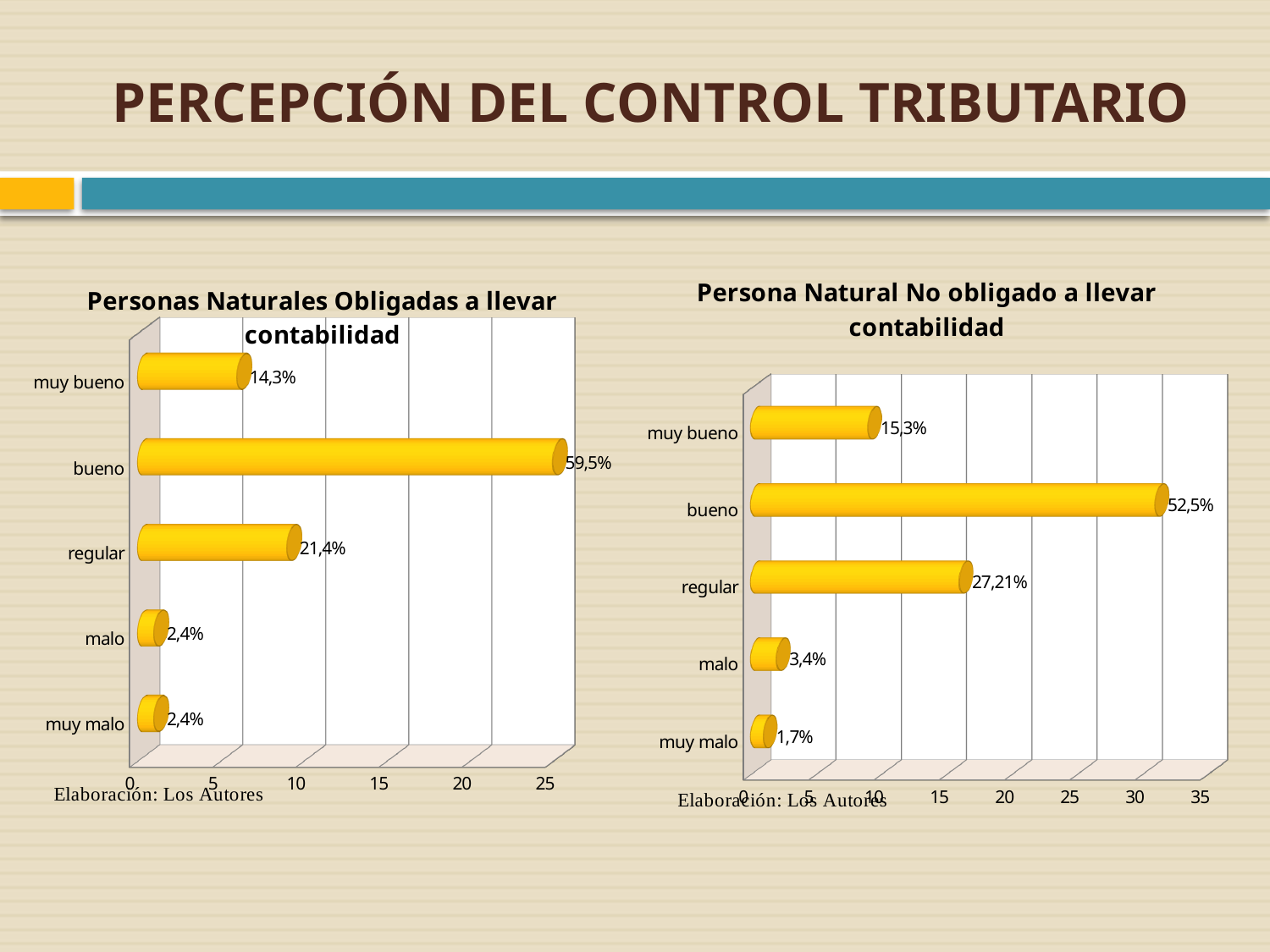
In the chart titled 'Personas Naturales Obligadas a llevar contabilidad', what is the value for 'muy bueno'? 14,3% In the chart titled 'Persona Natural No obligado a llevar contabilidad', which category has the lowest value? muy malo In the chart titled 'Persona Natural No obligado a llevar contabilidad', which category has the highest value? bueno In the chart titled 'Personas Naturales Obligadas a llevar contabilidad', what is the difference between the values for 'bueno' and 'regular'? 38,1 percentage points In the chart titled 'Personas Naturales Obligadas a llevar contabilidad', which category has the highest value? bueno In the chart titled 'Personas Naturales Obligadas a llevar contabilidad', what is the value for 'bueno'? 59,5% In the chart titled 'Persona Natural No obligado a llevar contabilidad', which is larger, the value for 'regular' or the value for 'muy bueno'? regular How many categories are shown in the chart titled 'Personas Naturales Obligadas a llevar contabilidad'? 5 In the chart titled 'Persona Natural No obligado a llevar contabilidad', what is the value for 'regular'? 27,21% What kind of chart is the chart titled 'Persona Natural No obligado a llevar contabilidad'? bar chart In the chart titled 'Persona Natural No obligado a llevar contabilidad', what is the difference between the values for 'bueno' and 'muy bueno'? 37,2 percentage points In the chart titled 'Persona Natural No obligado a llevar contabilidad', what is the value for 'muy malo'? 1,7%